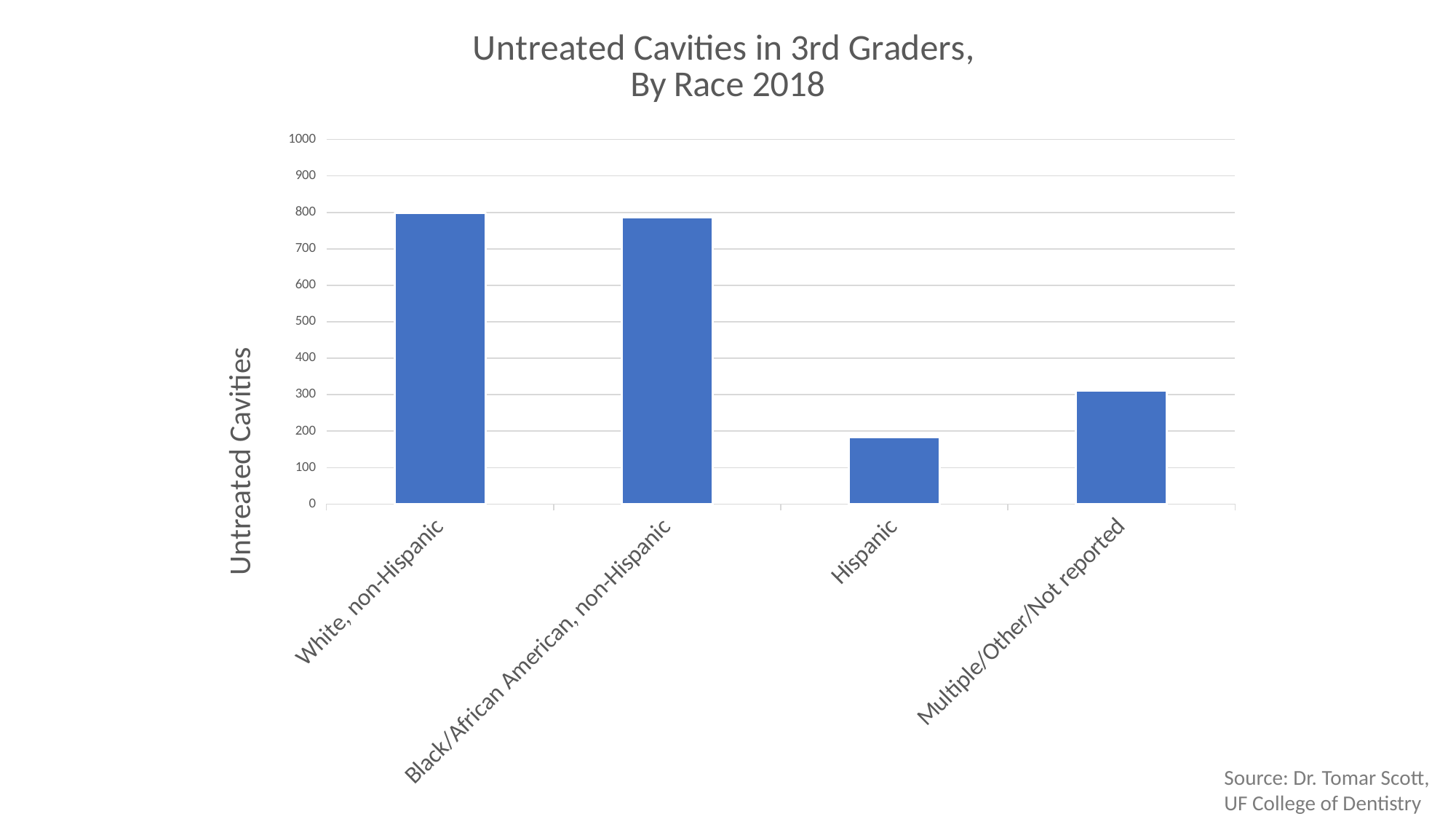
How many race categories are plotted in the chart? 4 Is the value for Hispanic greater or less than 200? less Which has more untreated cavities: Hispanic or Multiple/Other/Not reported? Multiple/Other/Not reported What is the label on the vertical axis of the chart? Untreated Cavities Which has more untreated cavities: White, non-Hispanic or Hispanic? White, non-Hispanic What kind of chart is shown on the slide? Bar chart What is the title of the chart? Untreated Cavities in 3rd Graders, By Race 2018 Is the value for White, non-Hispanic greater or less than 700? greater Which category has the lowest number of untreated cavities? Hispanic Is the value for Black/African American, non-Hispanic greater or less than 600? greater